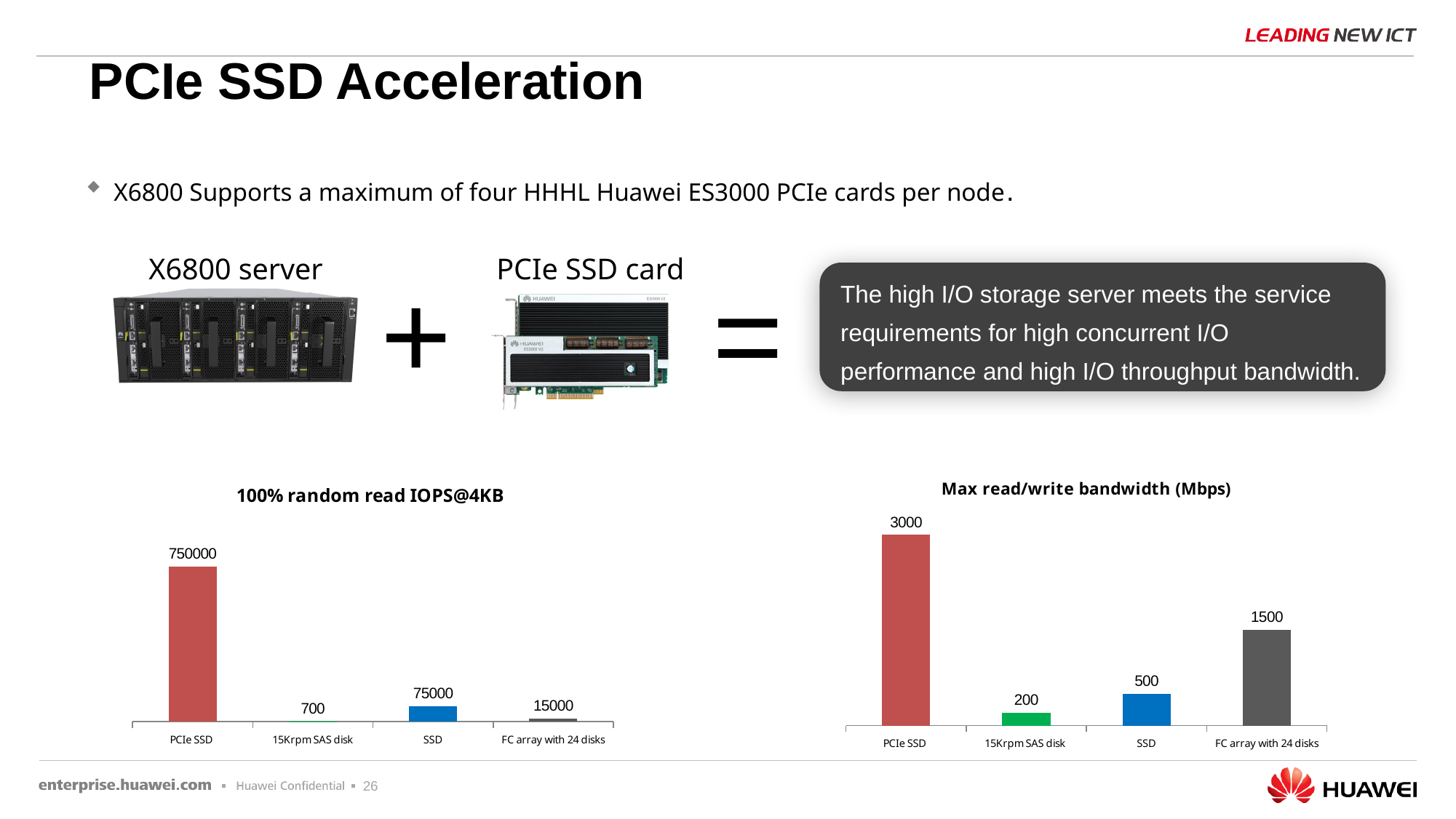
In the 'Max read/write bandwidth (Mbps)' chart, what is the value for FC array with 24 disks? 1500 In the '100% random read IOPS@4KB' chart, what is the difference between the PCIe SSD and SSD values? 675000 What is the title of the chart on the left side of the slide? 100% random read IOPS@4KB In the '100% random read IOPS@4KB' chart, which category has the lowest value? 15Krpm SAS disk In the 'Max read/write bandwidth (Mbps)' chart, what is the difference between the PCIe SSD and 15Krpm SAS disk values? 2800 In the '100% random read IOPS@4KB' chart, what is the value for PCIe SSD? 750000 In the '100% random read IOPS@4KB' chart, what is the value for the 15Krpm SAS disk? 700 In the '100% random read IOPS@4KB' chart, how many categories are shown? 4 What kind of chart is the 'Max read/write bandwidth (Mbps)' chart? Bar chart In the 'Max read/write bandwidth (Mbps)' chart, which is larger: the value for SSD or the value for FC array with 24 disks? FC array with 24 disks In the 'Max read/write bandwidth (Mbps)' chart, which category has the highest value? PCIe SSD In the 'Max read/write bandwidth (Mbps)' chart, what is the value for SSD? 500